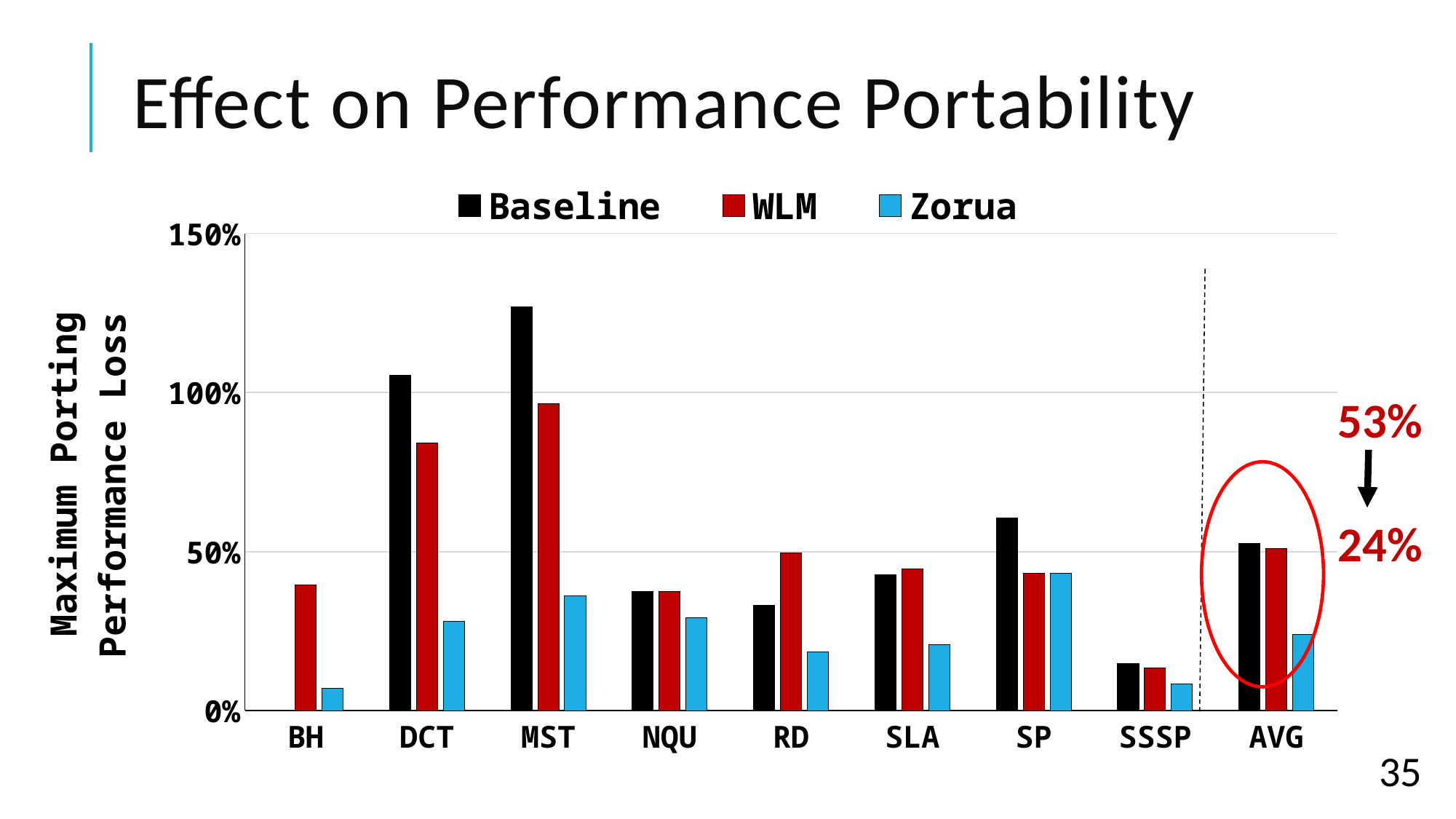
How many series does the legend list? 3 Is the Baseline value for SP greater or less than 50%? greater Is the Zorua value for BH greater or less than 50%? less What is the y-axis title of the chart? Maximum Porting Performance Loss Is the Baseline value for SSSP greater or less than 50%? less What is the Baseline value for AVG, as annotated on the slide? 53% For DCT, which is larger: the Baseline value or the WLM value? Baseline Which category has the highest Baseline bar? MST How many categories are shown along the x axis? 9 What kind of chart is shown on the slide? bar chart Which category has the lowest Zorua bar? BH